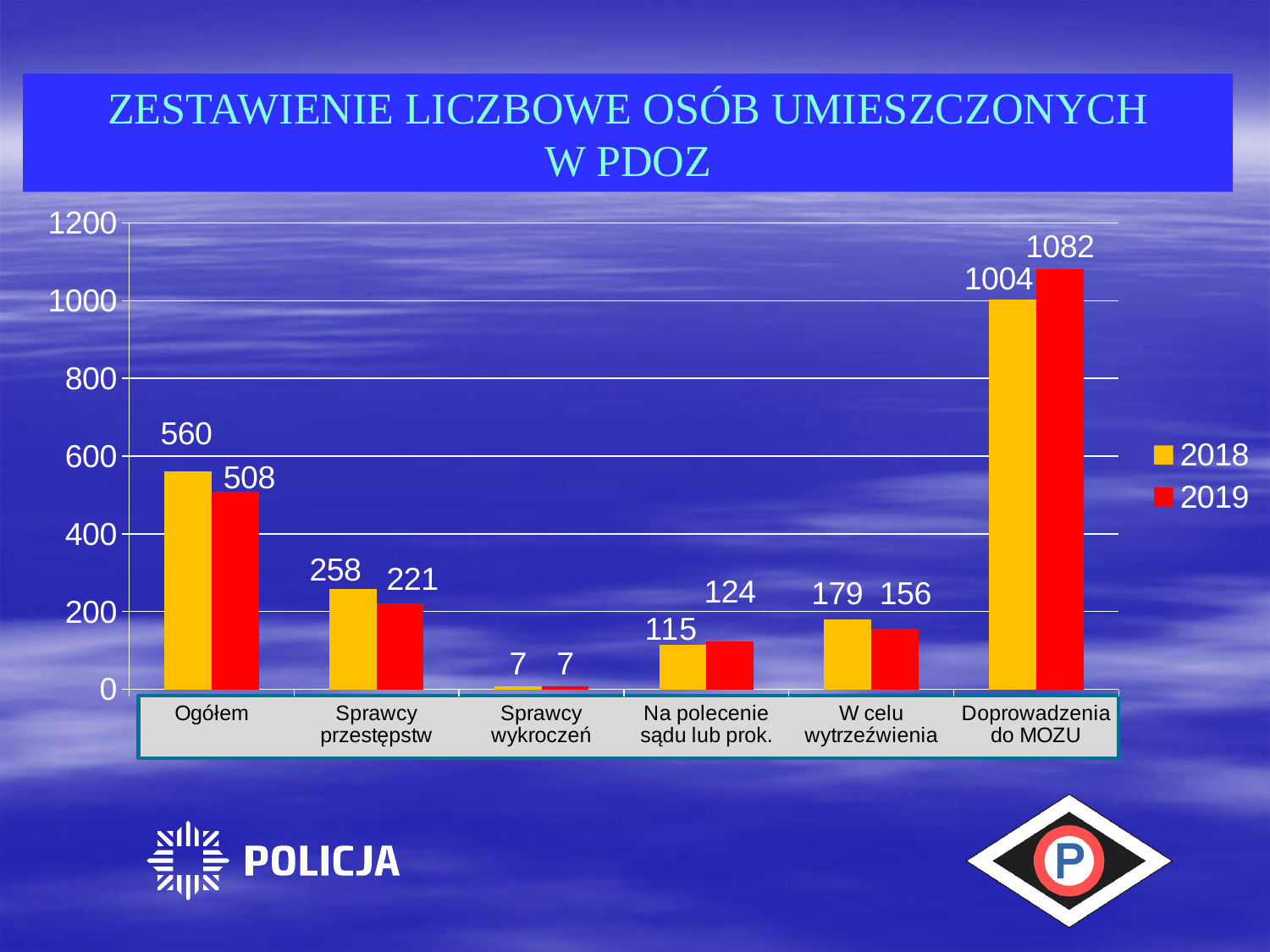
What is the difference between the 2018 and 2019 values for Sprawcy przestępstw? 37 How many categories are shown on the x axis? 6 What colour represents the 2019 series? red Which is larger for W celu wytrzeźwienia, the 2018 value or the 2019 value? 2018 What is the value for Doprowadzenia do MOZU in 2019? 1082 What kind of chart is shown on the slide? bar chart Which category has the lowest value in 2018? Sprawcy wykroczeń Which category has the highest value in 2019? Doprowadzenia do MOZU Is the 2019 value for Ogółem greater or less than 400? greater How many series does the legend list? 2 What is the value for Na polecenie sądu lub prok. in 2018? 115 What is the value for Ogółem in 2018? 560